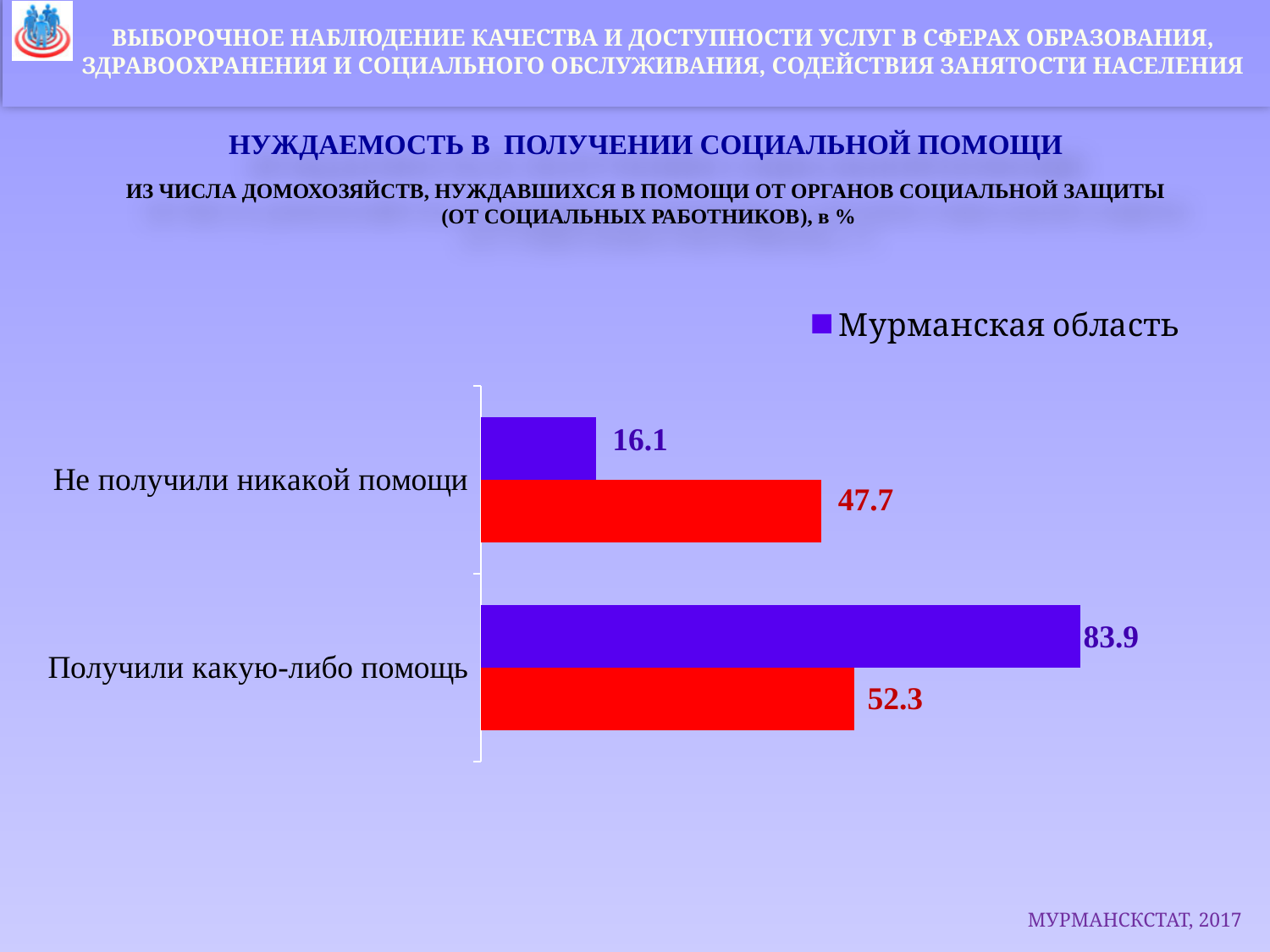
For Мурманская область, which is larger: the value for "Получили какую-либо помощь" or for "Не получили никакой помощи"? Получили какую-либо помощь Which category has the highest value for Мурманская область? Получили какую-либо помощь In the category "Не получили никакой помощи", which bar is longer, the blue one or the red one? the red one What kind of chart is shown on the slide? bar chart How many series does the legend list? 1 Which category has the lowest value for Мурманская область? Не получили никакой помощи What colour represents Мурманская область in the chart? blue What is the value for Мурманская область in the category "Получили какую-либо помощь"? 83.9 What series name is shown in the chart legend? Мурманская область What is the value for Мурманская область in the category "Не получили никакой помощи"? 16.1 How many categories are shown on the chart? 2 What is the difference between the Мурманская область values for "Получили какую-либо помощь" and "Не получили никакой помощи"? 67.8